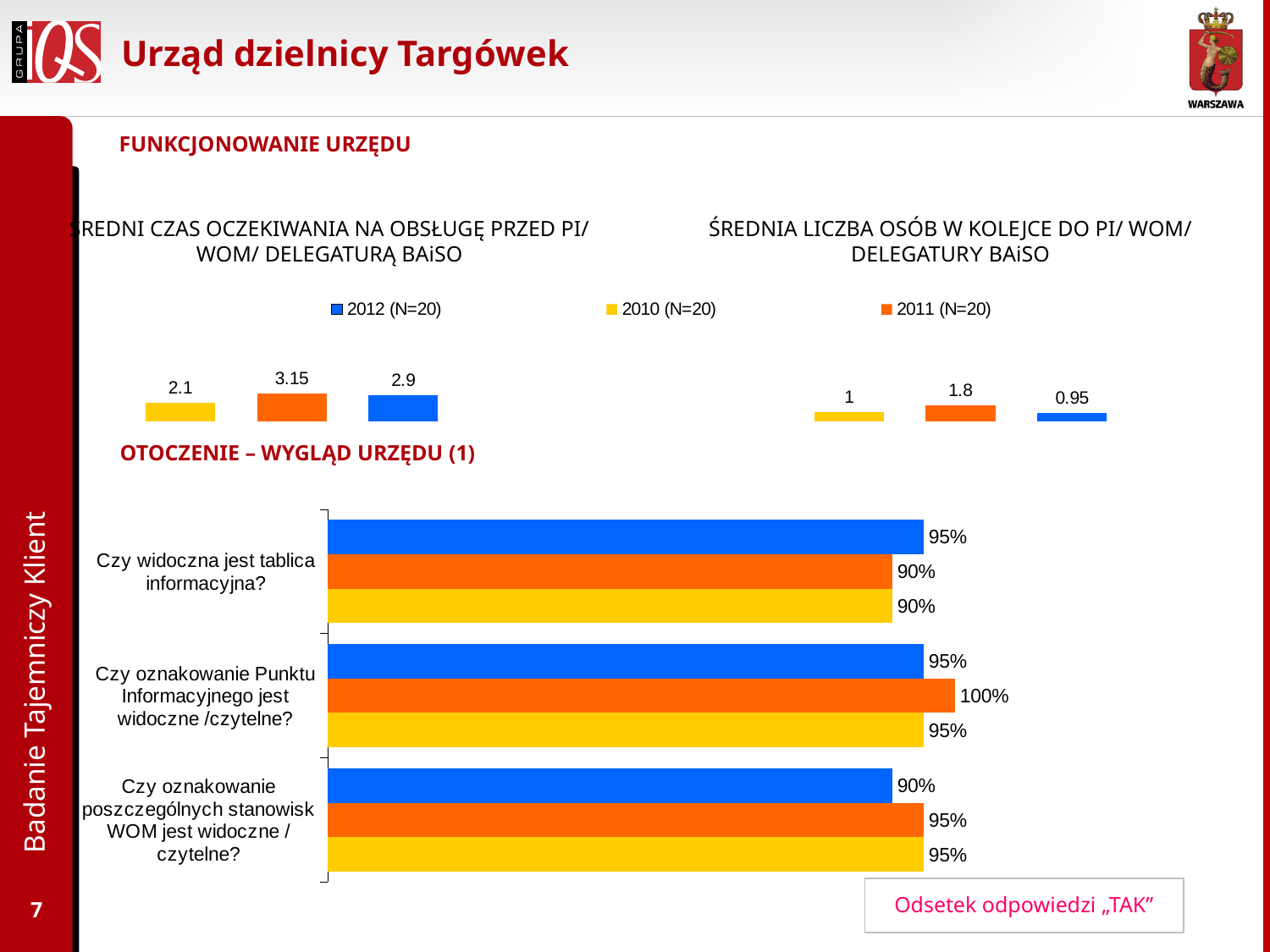
In the bottom chart under 'OTOCZENIE – WYGLĄD URZĘDU (1)', how many question categories are shown on the vertical axis? 3 In the bottom chart under 'OTOCZENIE – WYGLĄD URZĘDU (1)', what is the difference between the blue bar and the yellow bar for 'Czy widoczna jest tablica informacyjna?'? 5% In the bottom chart under 'OTOCZENIE – WYGLĄD URZĘDU (1)', what is the value of the blue bar for 'Czy oznakowanie poszczególnych stanowisk WOM jest widoczne / czytelne?'? 90% How many series does the legend above the top charts list? 3 What kind of chart is the bottom chart under 'OTOCZENIE – WYGLĄD URZĘDU (1)'? Bar chart In the bottom chart under 'OTOCZENIE – WYGLĄD URZĘDU (1)', what is the value of the orange bar for 'Czy oznakowanie Punktu Informacyjnego jest widoczne /czytelne?'? 100% In the chart 'ŚREDNIA LICZBA OSÓB W KOLEJCE DO PI/ WOM/ DELEGATURY BAiSO', is the value for 2010 larger or the value for 2011? 2011 In the chart 'ŚREDNI CZAS OCZEKIWANIA NA OBSŁUGĘ PRZED PI/ WOM/ DELEGATURĄ BAiSO', what is the difference between the 2011 and 2012 values? 0.25 In the chart 'ŚREDNI CZAS OCZEKIWANIA NA OBSŁUGĘ PRZED PI/ WOM/ DELEGATURĄ BAiSO', what is the value for 2011 (N=20)? 3.15 In the chart 'ŚREDNIA LICZBA OSÓB W KOLEJCE DO PI/ WOM/ DELEGATURY BAiSO', which year has the highest value? 2011 (N=20) In the chart 'ŚREDNI CZAS OCZEKIWANIA NA OBSŁUGĘ PRZED PI/ WOM/ DELEGATURĄ BAiSO', which year has the lowest value? 2010 (N=20) In the chart 'ŚREDNIA LICZBA OSÓB W KOLEJCE DO PI/ WOM/ DELEGATURY BAiSO', what is the value for 2012 (N=20)? 0.95